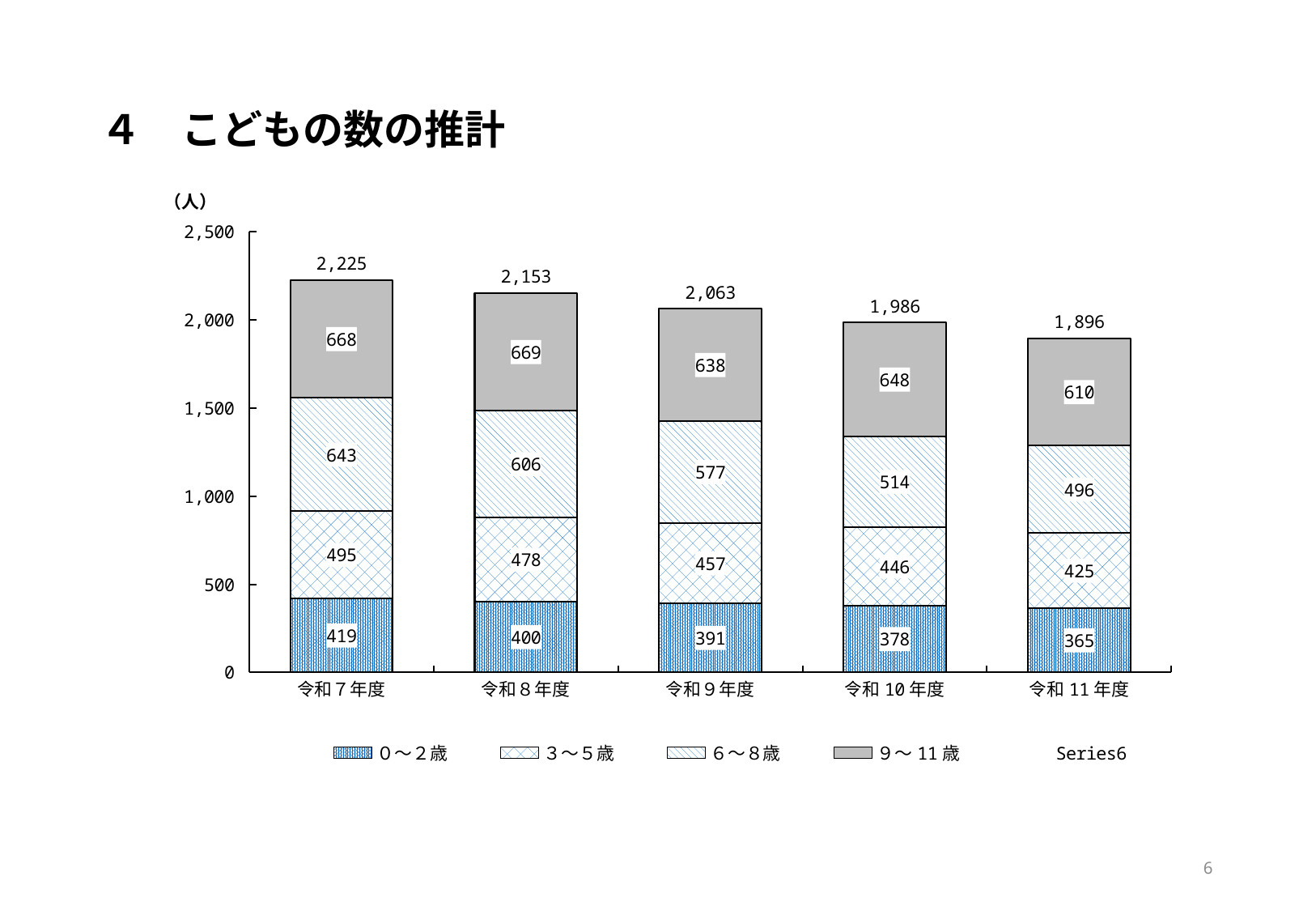
How many entries does the legend list? 5 What is the total of the stacked bar for 令和10年度? 1,986 Do the total values rise or fall from 令和７年度 to 令和11年度? Fall What is the value for 9～11歳 in 令和９年度? 638 Which fiscal year has the lowest value for 3～5歳? 令和11年度 What is the difference between the totals for 令和７年度 and 令和11年度? 329 Which fiscal year has the highest total? 令和７年度 What kind of chart is shown? Stacked bar chart Which is larger: the 9～11歳 value in 令和８年度 or in 令和10年度? 令和８年度 How many fiscal years are shown on the x axis? 5 What is the value for 0～2歳 in 令和７年度? 419 What is the value for 6～8歳 in 令和11年度? 496